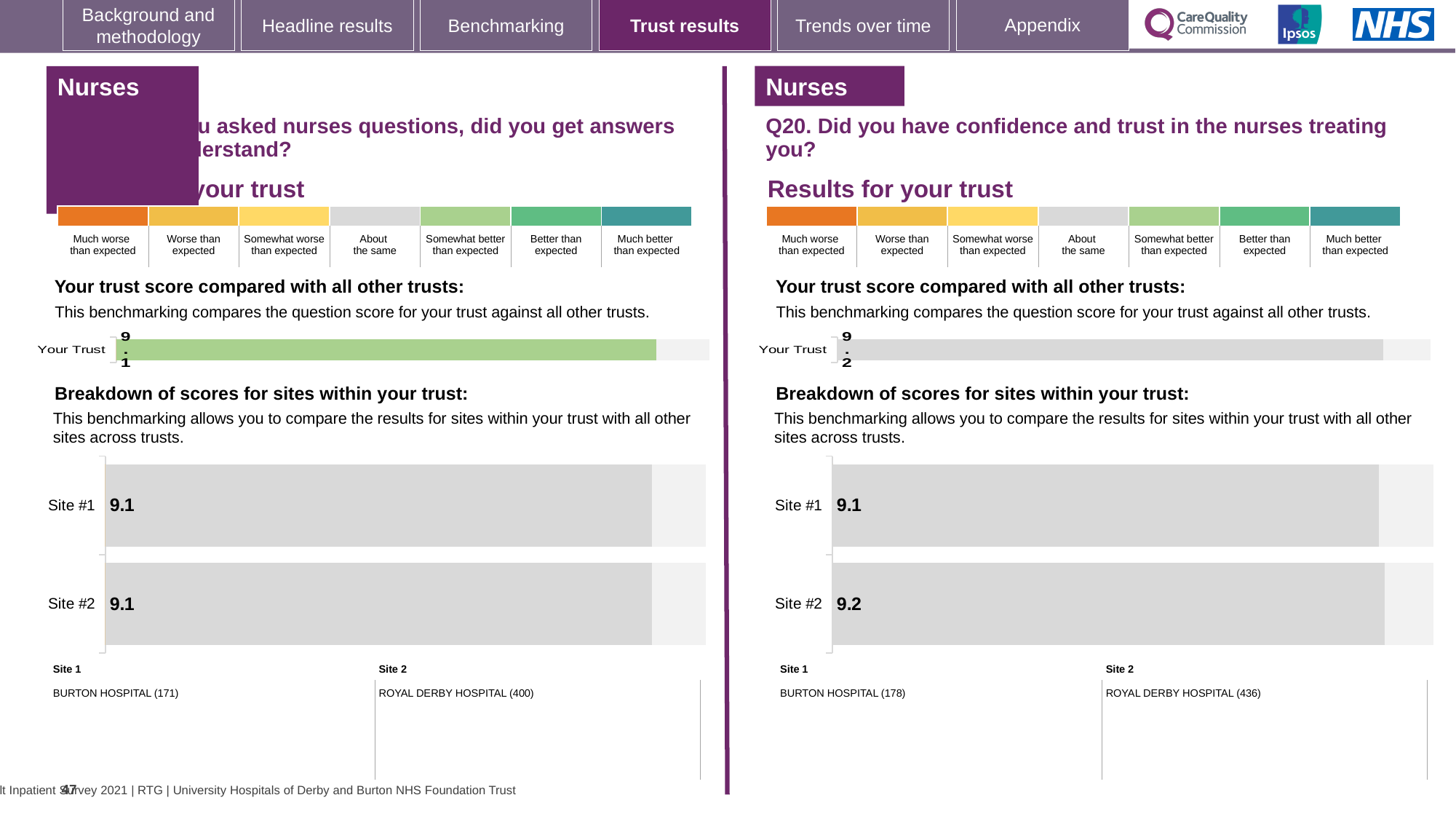
On the right-hand chart (Q20), what is the score shown for Your Trust? 9.2 On the left-hand site breakdown chart, what is the score for Site #2? 9.1 On the left-hand site breakdown chart, what is the score for Site #1? 9.1 On the left-hand chart, what colour is the Your Trust bar? Green On the right-hand site breakdown chart (Q20), which site has the higher score? Site #2 On the right-hand site breakdown chart (Q20), what is the score for Site #1? 9.1 What type of chart is used to show the site breakdown scores? Bar chart On the left-hand site breakdown chart, do Site #1 and Site #2 have the same score? Yes On the left-hand chart, what is the score shown for Your Trust? 9.1 On the right-hand site breakdown chart (Q20), what is the difference between the Site #2 and Site #1 scores? 0.1 On the right-hand site breakdown chart (Q20), what is the score for Site #2? 9.2 How many sites are shown in the right-hand site breakdown chart (Q20)? 2